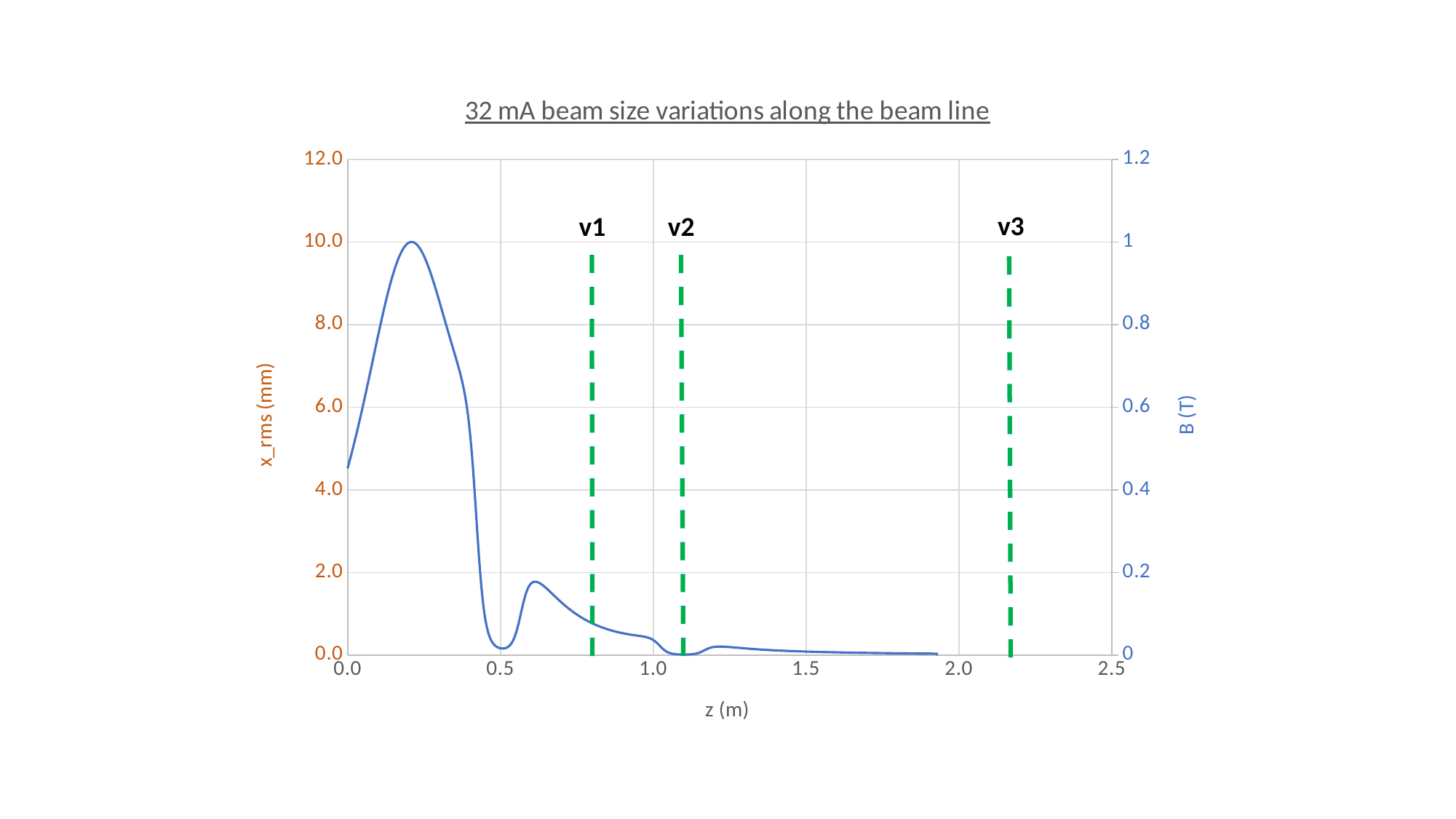
Is the value of x_rms at z = 0.0 greater or less than 4.0? greater What is the label of the left vertical axis? x_rms (mm) How many green dashed vertical marker lines are drawn on the chart? 3 Is the peak value of x_rms greater or less than 8.0? greater Which of the labelled dashed lines, v1 or v3, is located at a larger z value? v3 What is the title of the chart? 32 mA beam size variations along the beam line Between z = 0.2 and z = 0.5, does x_rms rise or fall? fall Is the value of x_rms at z = 1.5 greater or less than 2.0? less Between z = 0.0 and z = 0.2, does x_rms rise or fall? rise What kind of chart is shown on the slide? line chart Is x_rms at z = 0.2 larger or smaller than x_rms at z = 1.0? larger